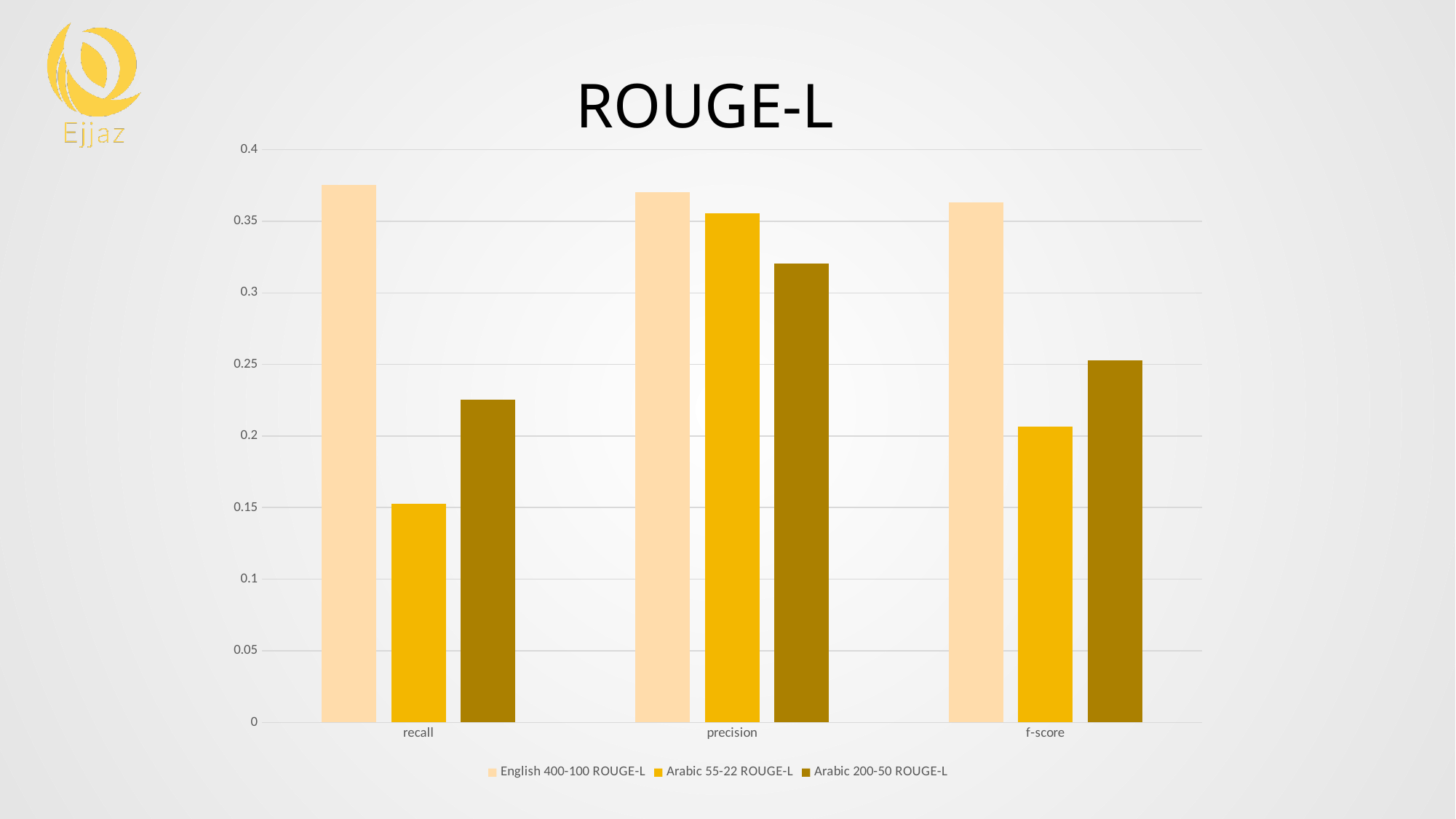
In which category does Arabic 55-22 ROUGE-L have its highest value? precision Is the value for English 400-100 ROUGE-L at recall greater or less than 0.35? greater What type of chart is shown on the slide? bar chart Is the value for Arabic 200-50 ROUGE-L at precision greater or less than 0.3? greater In which category does Arabic 55-22 ROUGE-L have its lowest value? recall Is the value for Arabic 55-22 ROUGE-L at f-score greater or less than 0.25? less For f-score, which is larger: Arabic 55-22 ROUGE-L or Arabic 200-50 ROUGE-L? Arabic 200-50 ROUGE-L What is the title of the chart? ROUGE-L For precision, which is larger: Arabic 55-22 ROUGE-L or Arabic 200-50 ROUGE-L? Arabic 55-22 ROUGE-L How many series does the legend list? 3 How many categories are shown on the x axis? 3